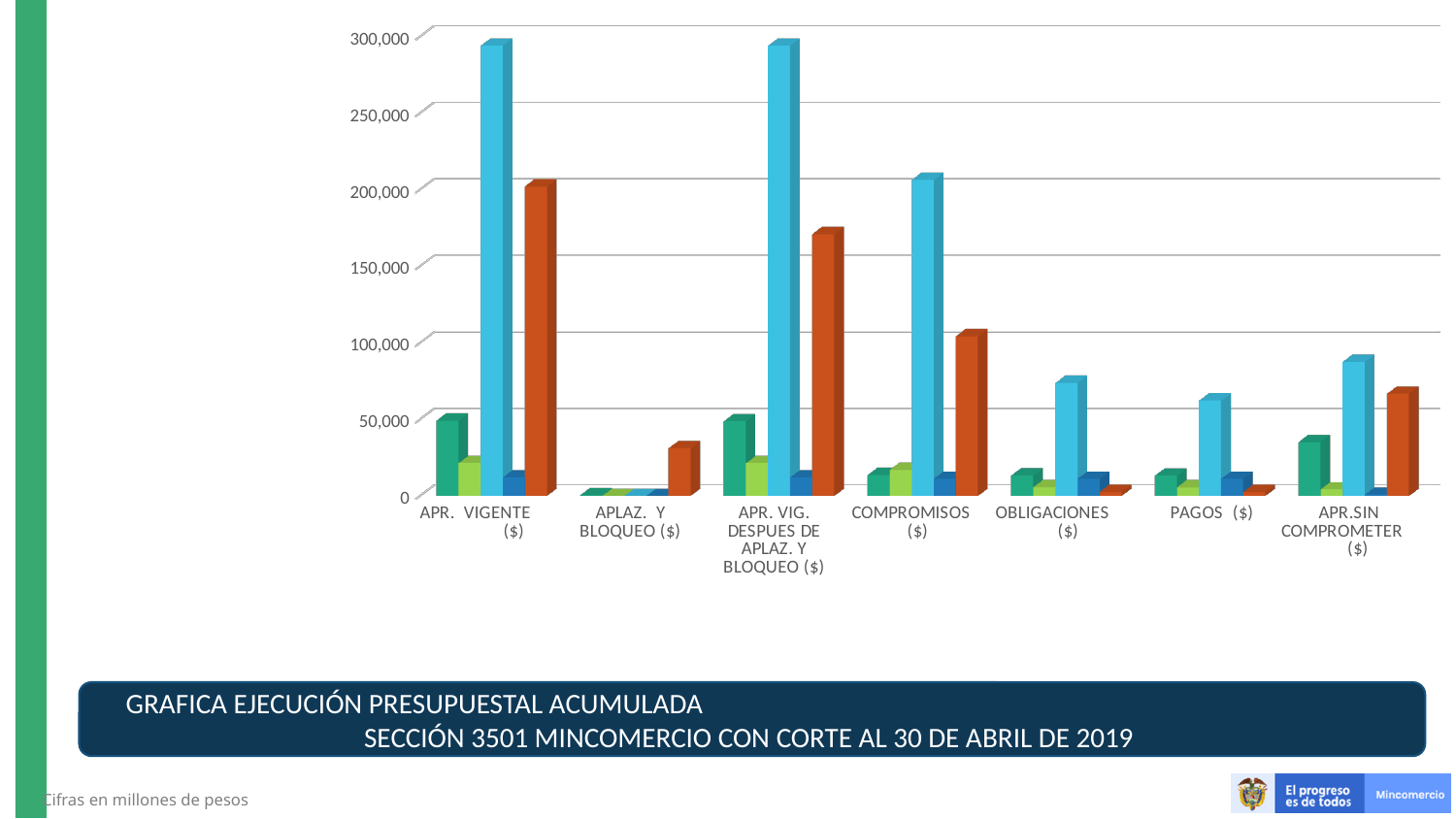
Is the value of the light blue bar for COMPROMISOS ($) greater or less than 150,000? greater Which is larger: the orange bar for APR. VIGENTE ($) or the orange bar for APR. VIG. DESPUES DE APLAZ. Y BLOQUEO ($)? APR. VIGENTE ($) Which is larger: the light blue bar for OBLIGACIONES ($) or the light blue bar for PAGOS ($)? OBLIGACIONES ($) What is the title shown in the box below the chart? GRAFICA EJECUCIÓN PRESUPUESTAL ACUMULADA SECCIÓN 3501 MINCOMERCIO CON CORTE AL 30 DE ABRIL DE 2019 How many categories are shown along the horizontal axis of the chart? 7 Is the value of the light blue bar for APR. VIGENTE ($) greater or less than 250,000? greater What kind of chart is shown on the slide? bar chart Is the value of the light blue bar for APR.SIN COMPROMETER ($) greater or less than 100,000? less Which category has the tallest orange bar? APR. VIGENTE ($)